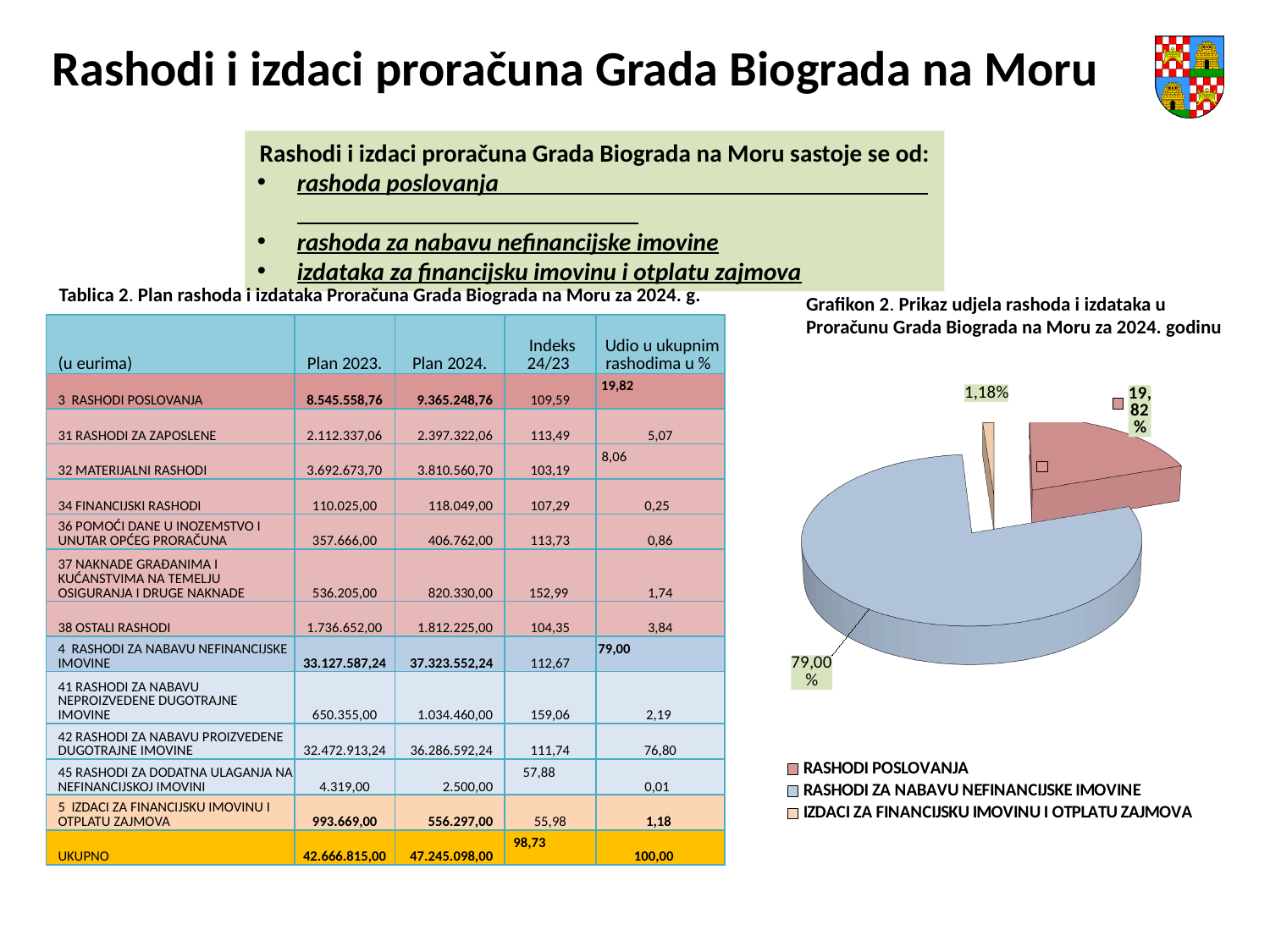
How many slices does the pie chart have? 3 What is the title of the chart on the slide? Grafikon 2. Prikaz udjela rashoda i izdataka u Proračunu Grada Biograda na Moru za 2024. godinu Which category has the smallest slice of the pie? IZDACI ZA FINANCIJSKU IMOVINU I OTPLATU ZAJMOVA What type of chart is shown on the slide? Pie chart What is the difference in percentage points between the RASHODI ZA NABAVU NEFINANCIJSKE IMOVINE slice and the RASHODI POSLOVANJA slice? 59,18 How many entries does the chart legend list? 3 Which category has the largest slice of the pie? RASHODI ZA NABAVU NEFINANCIJSKE IMOVINE Which is larger: the slice for RASHODI POSLOVANJA or the slice for IZDACI ZA FINANCIJSKU IMOVINU I OTPLATU ZAJMOVA? RASHODI POSLOVANJA What share of the pie does IZDACI ZA FINANCIJSKU IMOVINU I OTPLATU ZAJMOVA represent? 1,18% What is the difference in percentage points between the RASHODI POSLOVANJA slice and the IZDACI ZA FINANCIJSKU IMOVINU I OTPLATU ZAJMOVA slice? 18,64 What share of the pie does RASHODI ZA NABAVU NEFINANCIJSKE IMOVINE represent? 79,00% What share of the pie does RASHODI POSLOVANJA represent? 19,82%